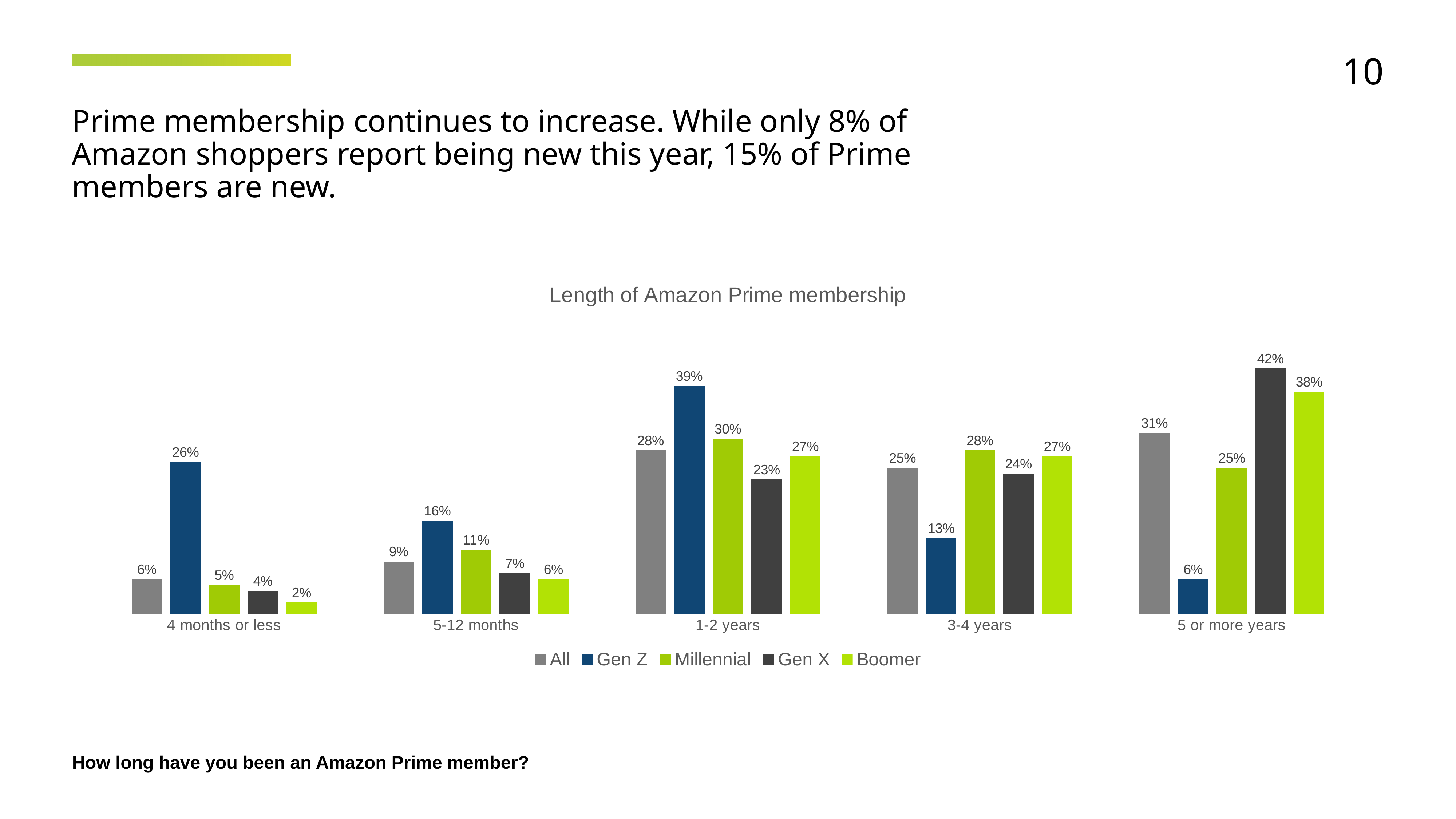
Which series has the highest value in the 1-2 years category? Gen Z Which series has the lowest value in the 4 months or less category? Boomer What is the value for Boomer in the 5-12 months category? 6% What is the value for Gen Z in the 4 months or less category? 26% What kind of chart is shown on the slide? Bar chart What is the value for Gen X in the 5 or more years category? 42% How many series does the legend list? 5 How many categories are shown on the x axis? 5 What is the value for All in the 1-2 years category? 28% Which is larger in the 3-4 years category: Millennial or Gen Z? Millennial What is the difference between the Gen X and Gen Z values in the 5 or more years category? 36% What is the title of the chart? Length of Amazon Prime membership